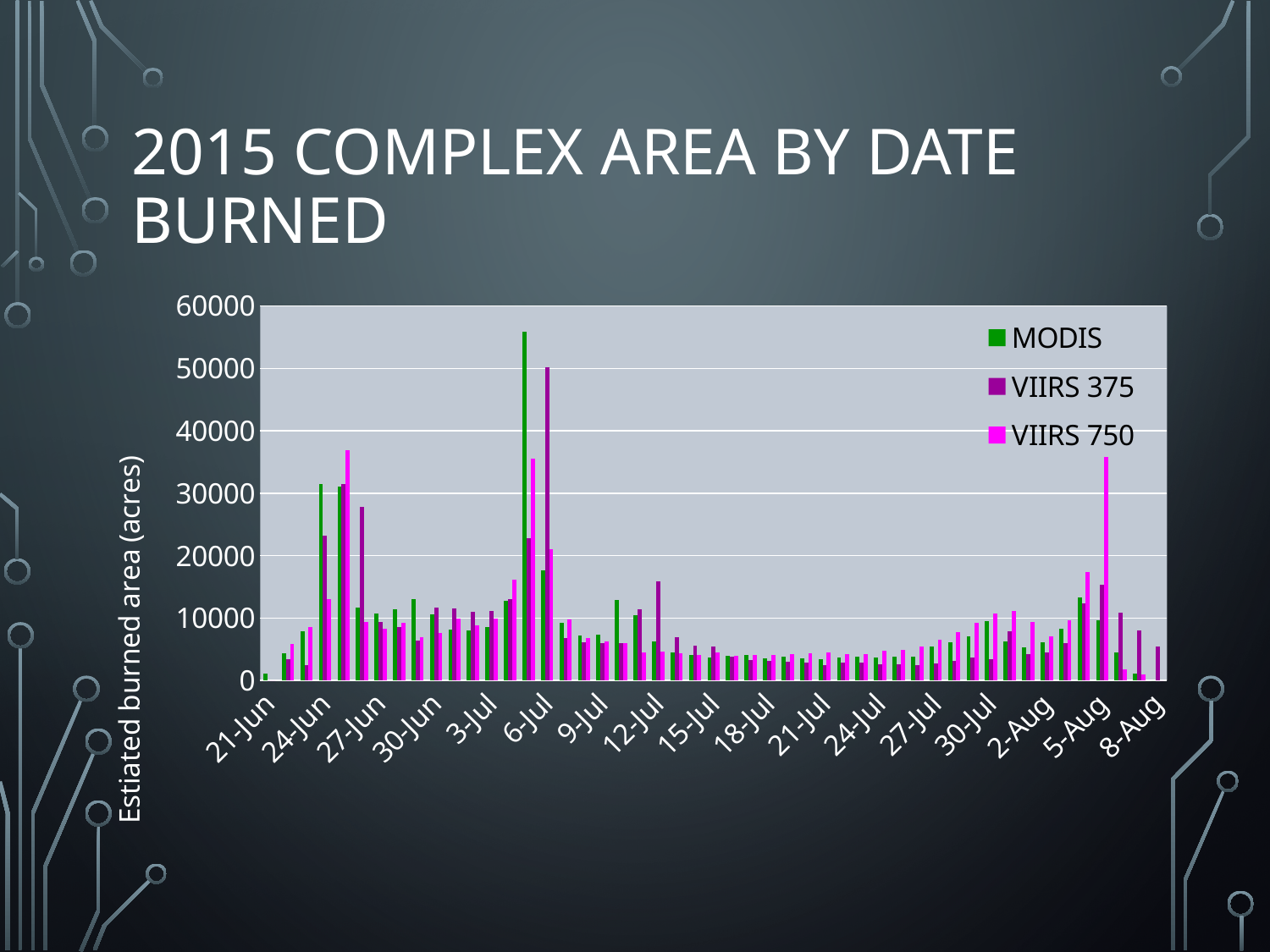
What are the series names listed in the legend? MODIS, VIIRS 375, VIIRS 750 How many series does the legend list? 3 Which series has the tallest bar anywhere on the chart? MODIS What kind of chart is shown on the slide? bar chart Is the tallest VIIRS 750 bar greater or less than 40000? less Is the tall VIIRS 750 bar near 5-Aug greater or less than 30000? greater Is the tallest VIIRS 375 bar greater or less than 40000? greater What is the title of the chart on the slide? 2015 Complex Area by Date Burned Which is larger: the tallest MODIS bar or the tallest VIIRS 375 bar? the tallest MODIS bar